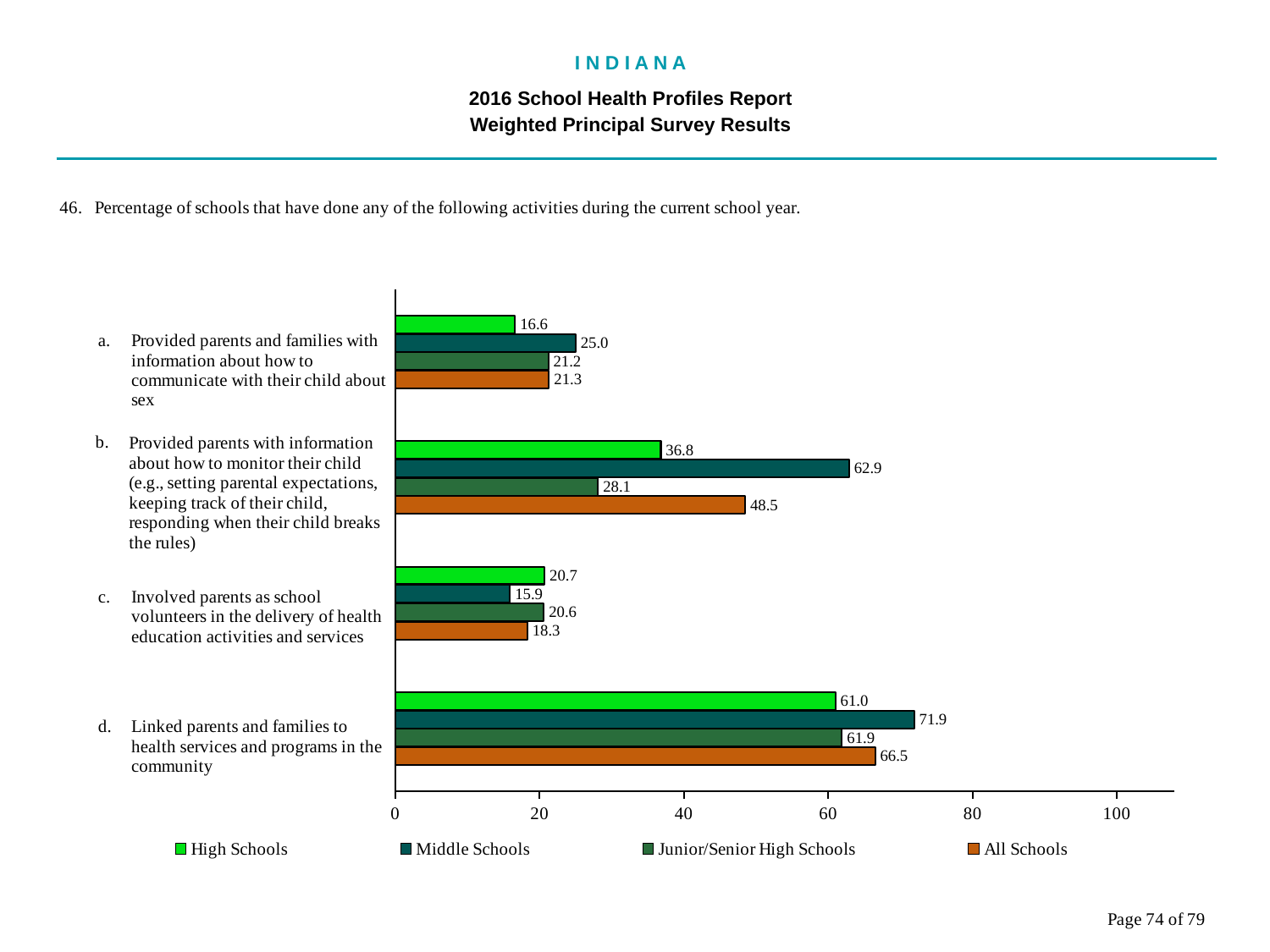
How many activities (categories) are shown on the chart? 4 How many series does the legend list? 4 Which school type has the lowest value for activity c (involved parents as school volunteers)? Middle Schools What is the difference between the Middle Schools and High Schools values for activity b? 26.1 What is the value for All Schools for activity d (linked parents and families to health services and programs in the community)? 66.5 What kind of chart is shown on the slide? Bar chart What is the value for Middle Schools for activity b (provided parents with information about how to monitor their child)? 62.9 Which activity has the highest value for Middle Schools? d. Linked parents and families to health services and programs in the community For activity d, which is larger: the value for Junior/Senior High Schools or the value for High Schools? Junior/Senior High Schools Which series is shown in orange in the legend? All Schools Is the All Schools value for activity b greater or less than 40? greater What is the value for High Schools for activity a (provided parents and families with information about how to communicate with their child about sex)? 16.6